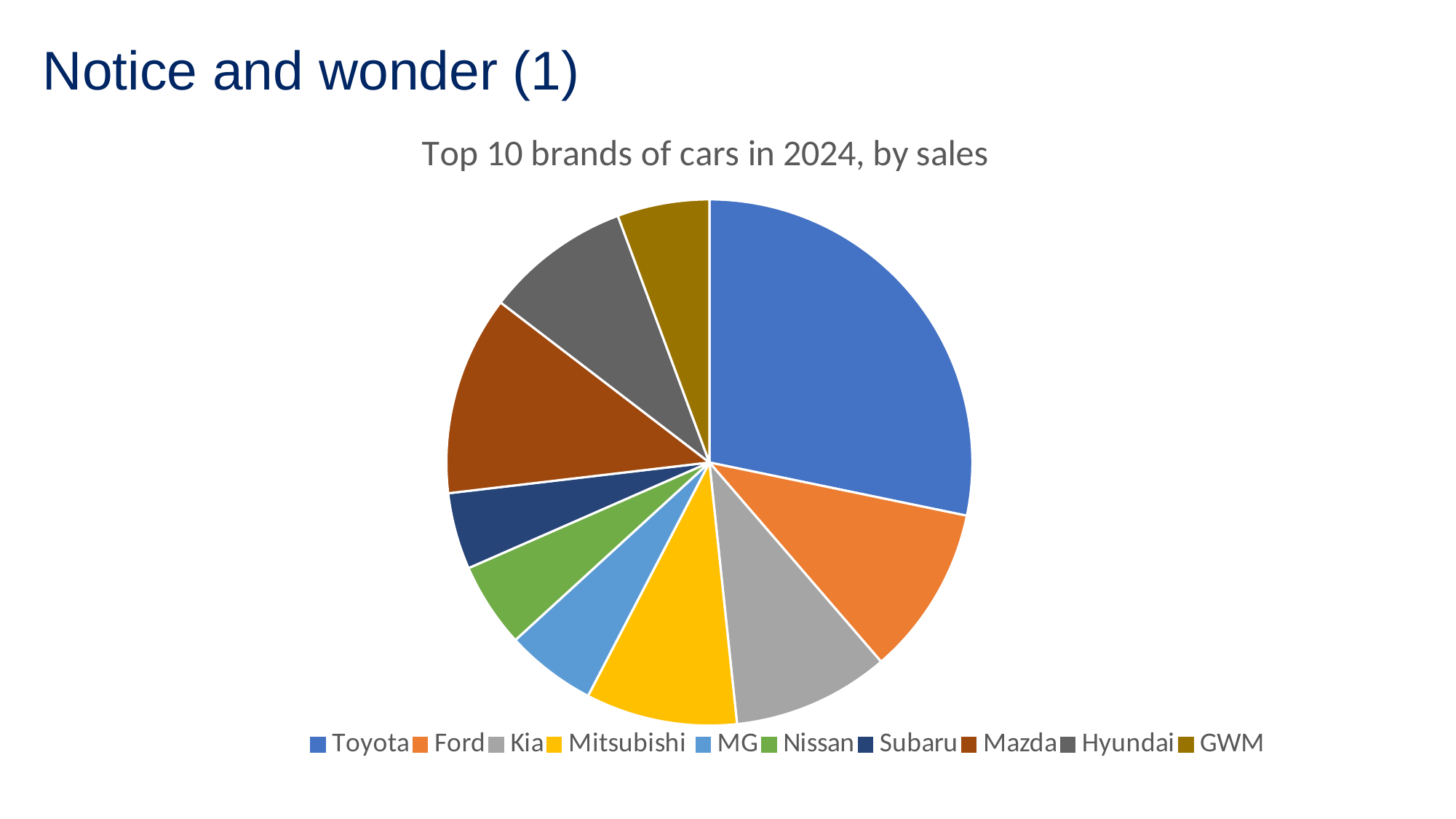
Which is larger, the slice for Kia or the slice for Nissan? Kia Which is larger, the slice for Toyota or the slice for Ford? Toyota How many brands (slices) does the pie chart show? 10 What is the title of the chart? Top 10 brands of cars in 2024, by sales Which is larger, the slice for Mitsubishi or the slice for MG? Mitsubishi Which brand has the largest slice of the pie? Toyota Which brand is listed first in the legend? Toyota What kind of chart is shown on the slide? Pie chart